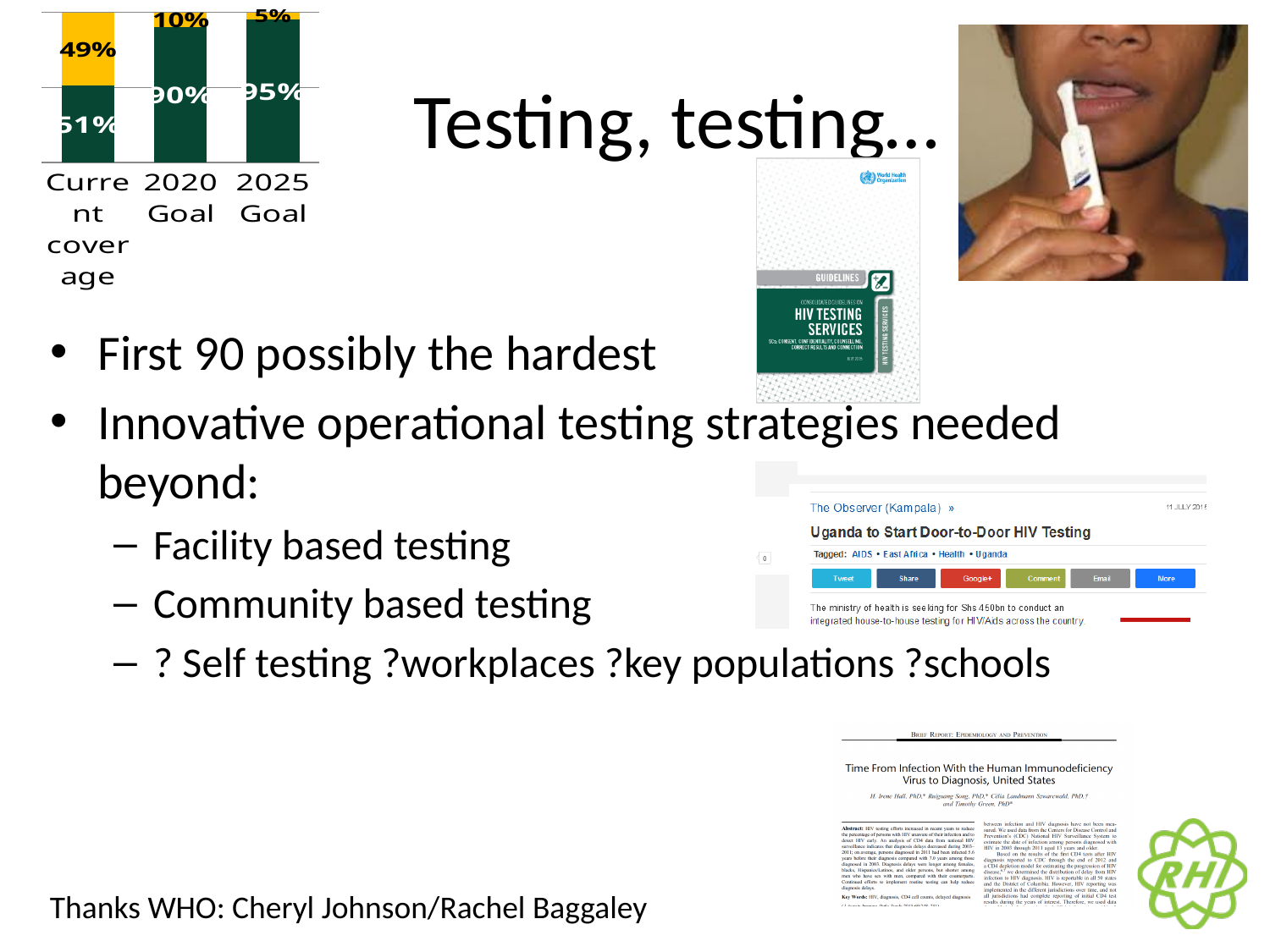
How many categories are shown on the x axis of the bar chart? 3 What is the total of the stacked bar for Current coverage? 100% What is the value of the green segment for the 2020 Goal? 90% What is the value of the green segment for Current coverage? 51% What is the value of the yellow segment for Current coverage? 49% Which category has the largest green segment? 2025 Goal What is the value of the yellow segment for the 2025 Goal? 5% Do the green segment values rise or fall from Current coverage to the 2025 Goal? rise Which is larger, the yellow segment for the 2020 Goal or the yellow segment for the 2025 Goal? 2020 Goal Which category has the smallest yellow segment? 2025 Goal What kind of chart is shown at the top left of the slide? stacked bar chart What is the difference between the green segment for the 2020 Goal and the green segment for Current coverage? 39%